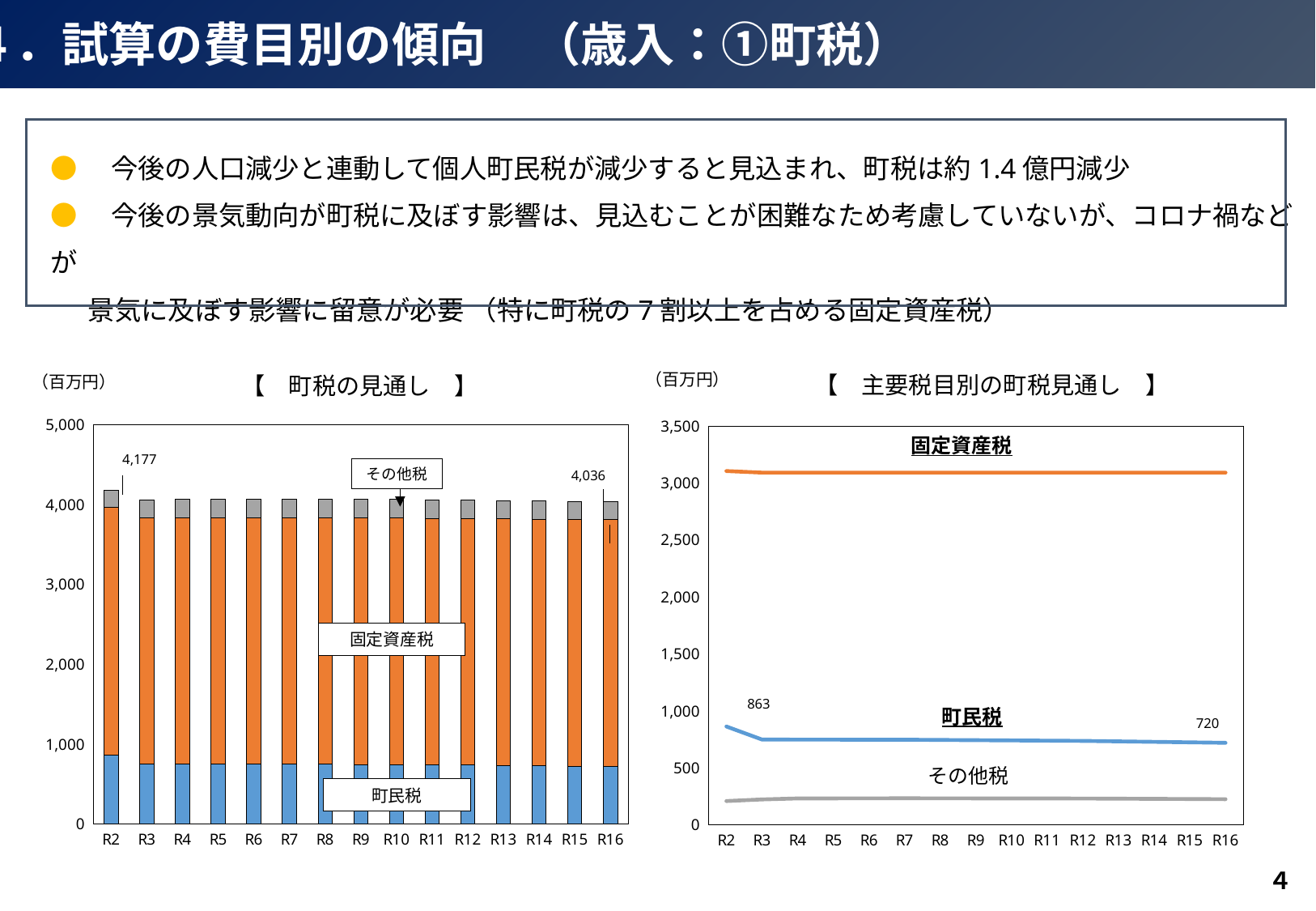
What kind of chart is the 主要税目別の町税見通し chart on the right? Line chart In the 主要税目別の町税見通し chart, is the value for 固定資産税 at R2 greater or less than 3,000? greater What kind of chart is the 町税の見通し chart on the left? Stacked bar chart In the 主要税目別の町税見通し chart, what is the value labelled for 町民税 at R2? 863 In the 町税の見通し chart, what is the total value labelled for R16? 4,036 In the 町税の見通し chart, what is the difference between the labelled totals for R2 and R16? 141 In the 町税の見通し chart, what is the total value labelled for R2? 4,177 In the 主要税目別の町税見通し chart, what is the value labelled for 町民税 at R16? 720 In the 主要税目別の町税見通し chart, does the 町民税 line rise or fall from R2 to R16? Fall In the 主要税目別の町税見通し chart, which tax line is the highest? 固定資産税 In the 主要税目別の町税見通し chart, by how much does the labelled 町民税 value fall from R2 to R16? 143 How many year categories are shown on the x axis of the 町税の見通し chart? 15